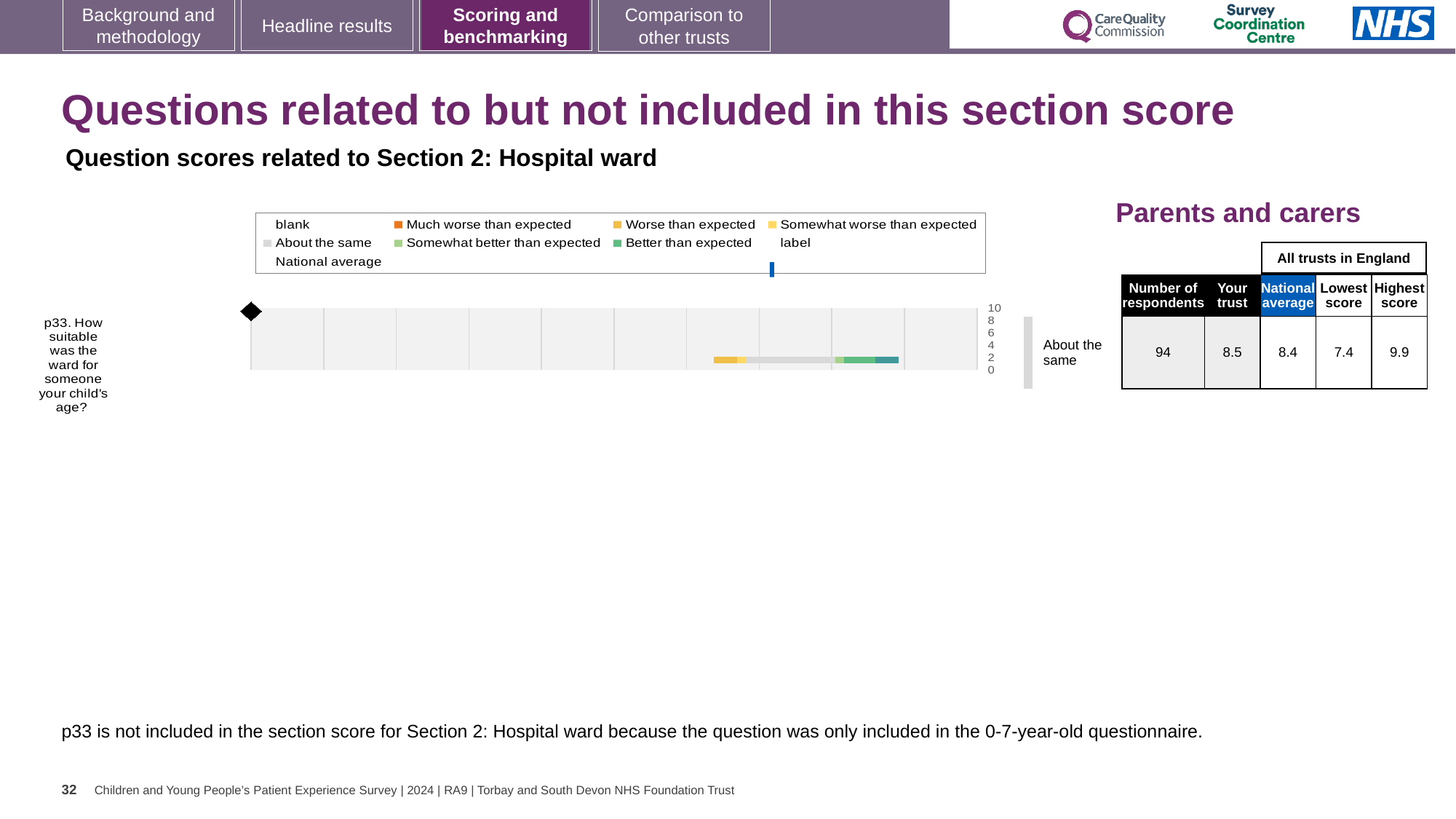
What is the highest score among all trusts in England for p33? 9.9 What kind of chart is shown for question p33? Bar chart What is the difference between the highest score and the lowest score for p33? 2.5 How many survey questions are plotted in the chart? 1 Which question is plotted in the chart? p33. How suitable was the ward for someone your child's age? What is the national average score for p33? 8.4 By how much does the 'Your trust' score for p33 exceed the national average? 0.1 Which is larger for p33: the 'Your trust' score or the national average? Your trust What benchmark category label is shown to the right of the bar for p33? About the same What is the lowest score among all trusts in England for p33? 7.4 What is the 'Your trust' score for p33 in the Parents and carers table? 8.5 How many respondents answered p33? 94